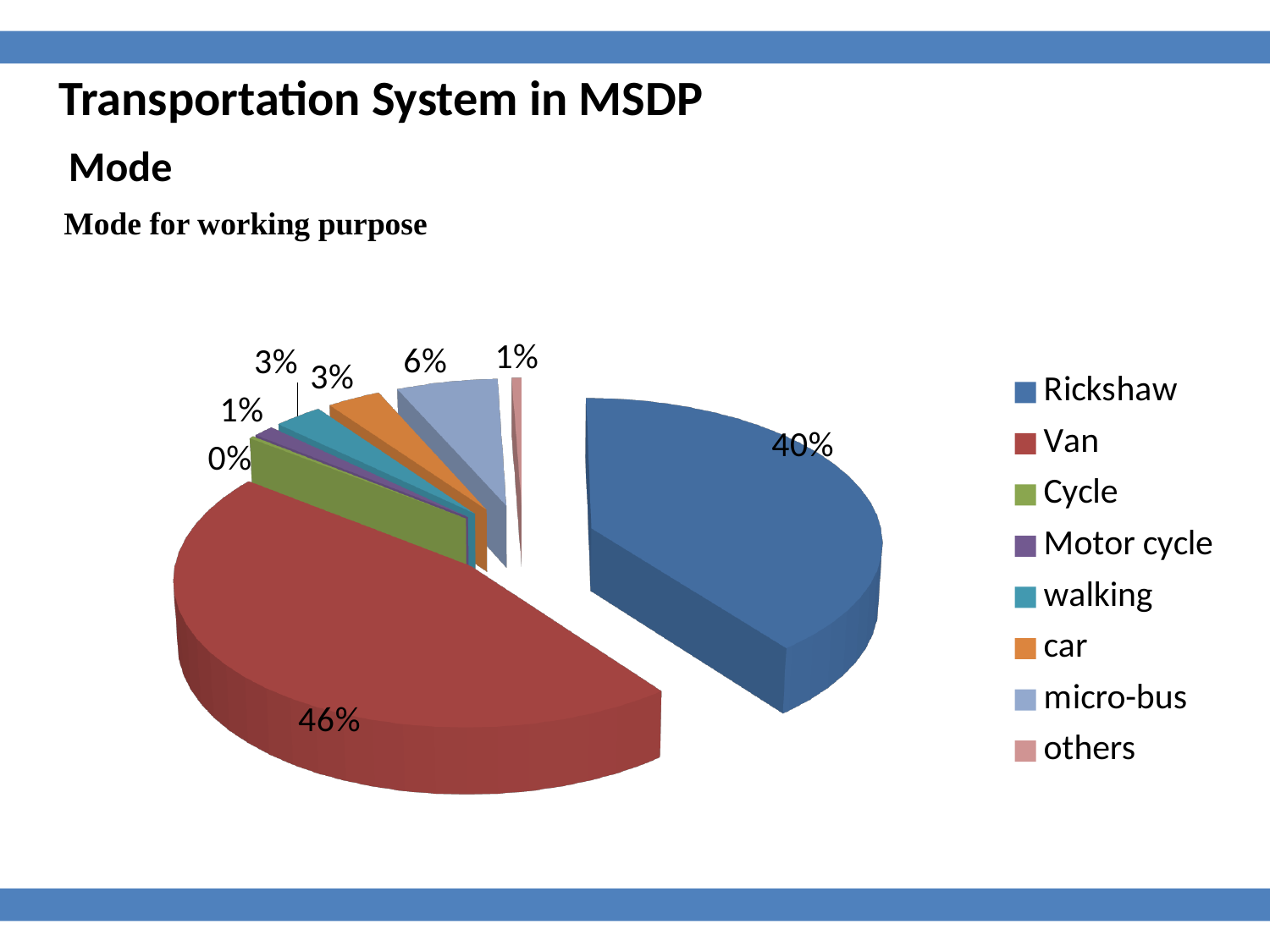
What type of chart is shown on the slide? pie chart Which legend entry is shown in red? Van Which is larger, the share for micro-bus or the share for others? micro-bus How many categories does the legend list? 8 What percentage of the pie is micro-bus? 6% What percentage of the pie is others? 1% What is the title text above the chart describing what the pie shows? Mode for working purpose What percentage of the pie is Van? 46% What percentage of the pie is Rickshaw? 40% Which mode has the largest share of the pie? Van Which is larger, the share for Van or the share for Rickshaw? Van How many percentage points larger is Van's share than Rickshaw's share? 6